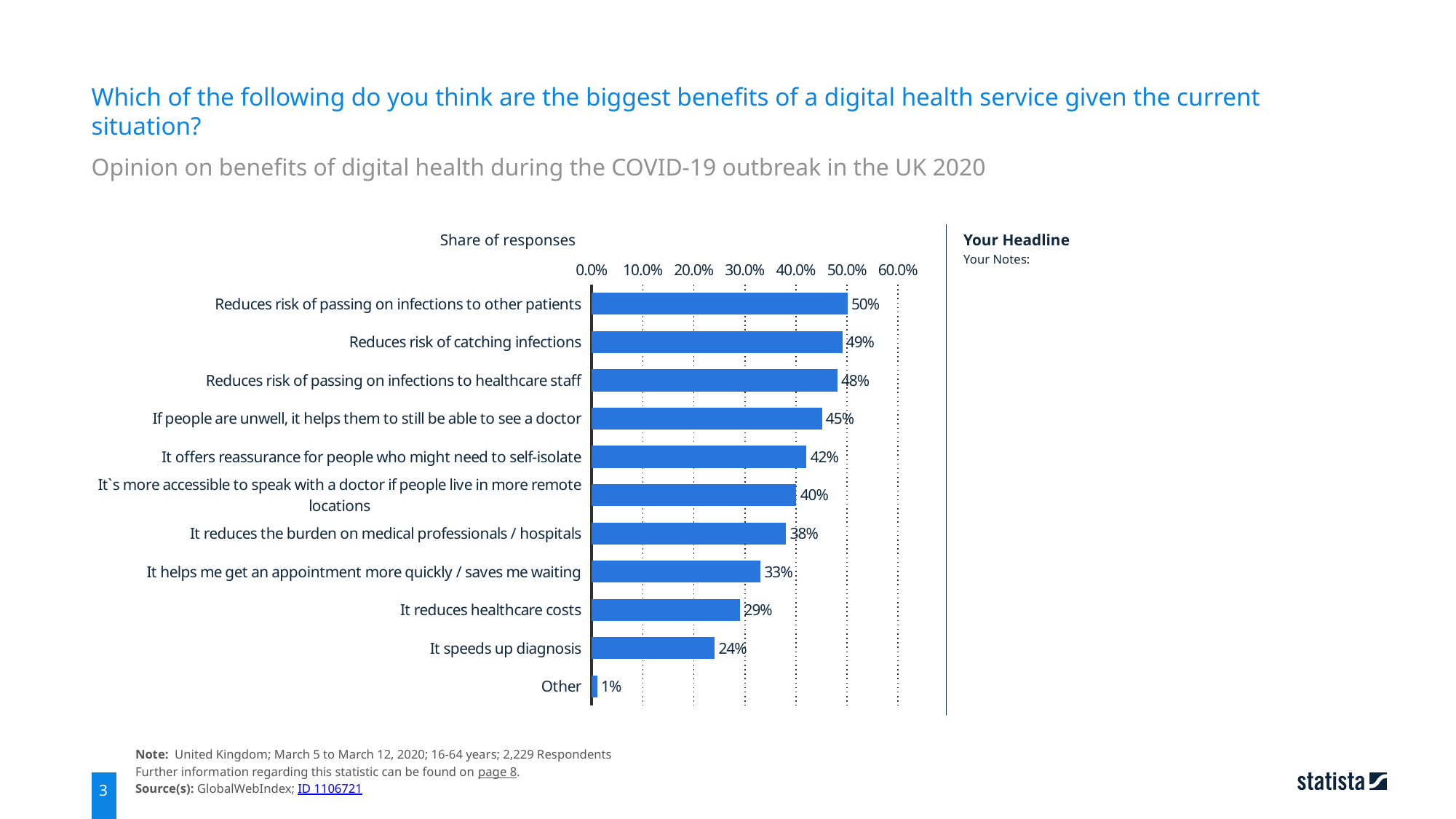
What share of responses is shown for "Reduces risk of catching infections"? 49% What is the difference in share of responses between "Reduces risk of passing on infections to other patients" and "Other"? 49% What kind of chart is shown on the slide? Bar chart Which category has the lowest share of responses? Other Which category has the highest share of responses? Reduces risk of passing on infections to other patients What is the difference in share of responses between "If people are unwell, it helps them to still be able to see a doctor" and "It offers reassurance for people who might need to self-isolate"? 3% Is the value for "It`s more accessible to speak with a doctor if people live in more remote locations" greater or less than 30.0%? greater What is the label of the value axis of the chart? Share of responses Which has a larger share of responses: "It reduces the burden on medical professionals / hospitals" or "It helps me get an appointment more quickly / saves me waiting"? It reduces the burden on medical professionals / hospitals How many categories are shown in the chart? 11 What share of responses is shown for "It speeds up diagnosis"? 24% What share of responses is shown for "It reduces healthcare costs"? 29%